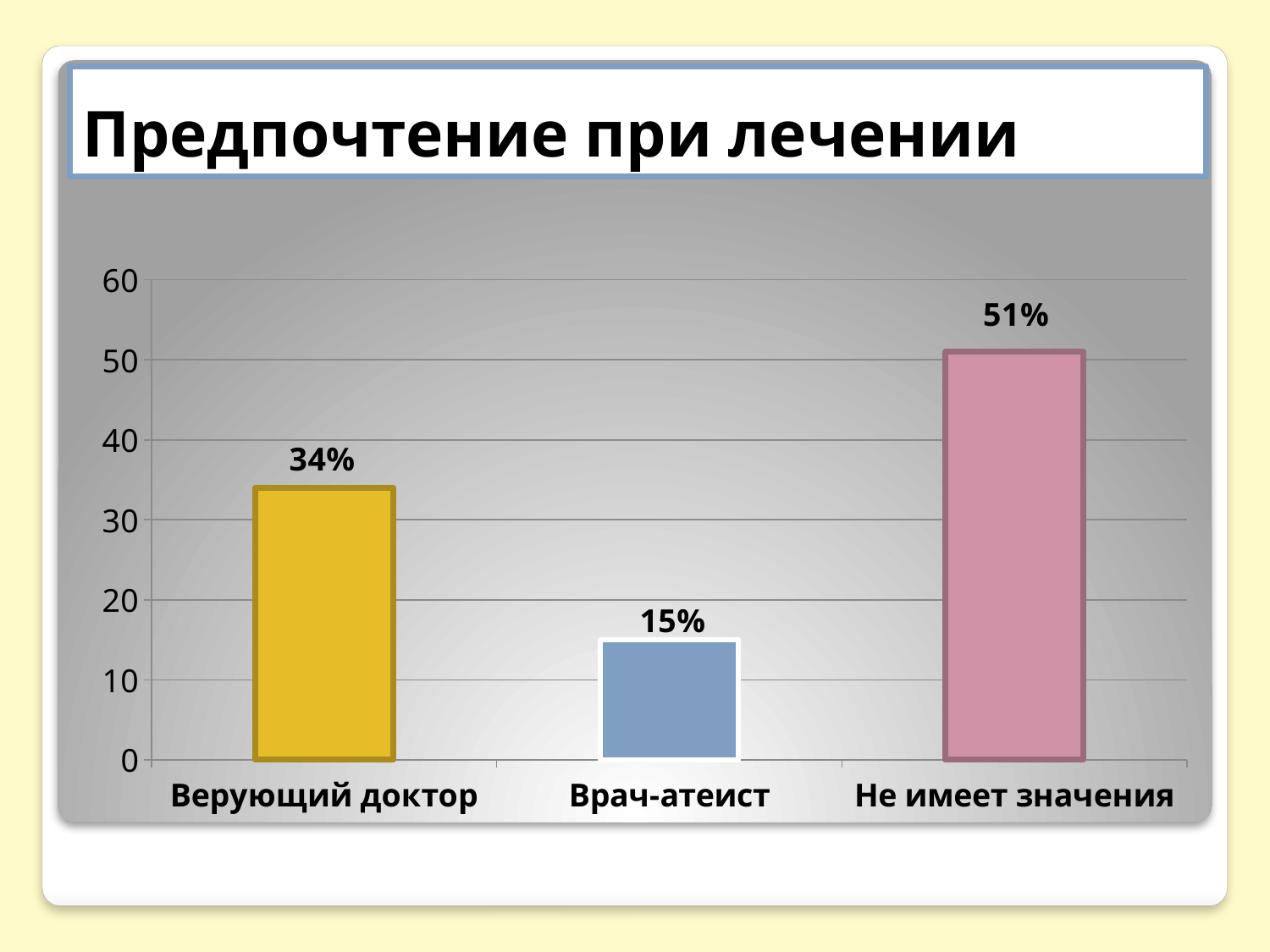
What kind of chart is shown on the slide? bar chart Is the value for Не имеет значения greater or less than 40? greater Which category has the lowest value? Врач-атеист What is the difference between the values for Верующий доктор and Врач-атеист? 19% What is the value for Не имеет значения? 51% What is the difference between the values for Не имеет значения and Верующий доктор? 17% What is the value for Верующий доктор? 34% What is the value for Врач-атеист? 15% What is the title of the chart? Предпочтение при лечении How many categories are shown on the chart? 3 Which category has the highest value? Не имеет значения Which is larger, the value for Верующий доктор or the value for Врач-атеист? Верующий доктор